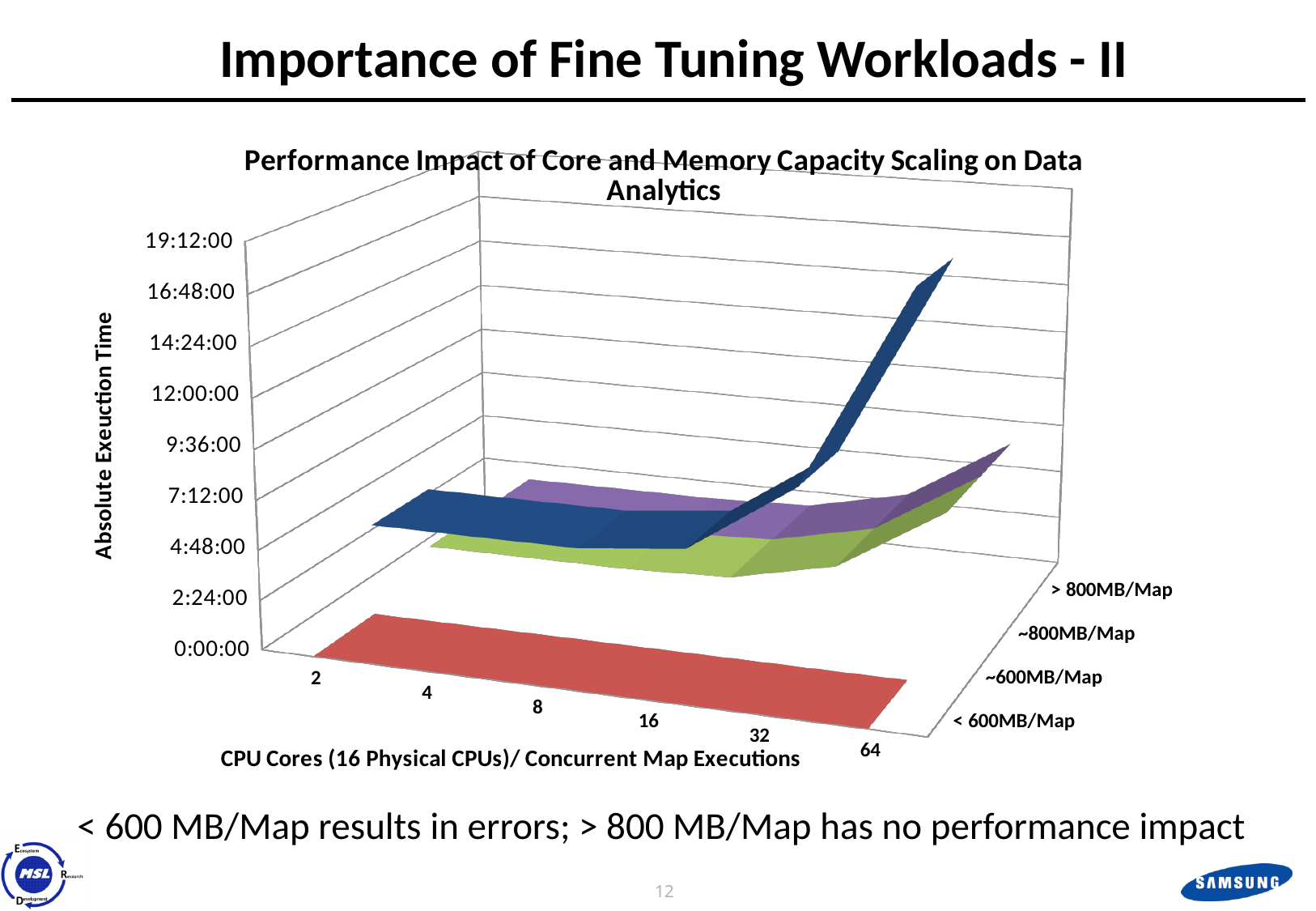
How many memory-per-map settings (series) are plotted in the chart? 4 Which memory-per-map setting has the lowest execution time across all CPU core values? < 600MB/Map Which memory-per-map setting has the highest execution time at 64 CPU cores? ~600MB/Map Which has the larger execution time at 64 CPU cores: > 800MB/Map or ~600MB/Map? ~600MB/Map Does the execution time for > 800MB/Map rise or fall as CPU cores increase from 32 to 64? rise What kind of chart is shown on the slide? 3D line chart What is the largest CPU core value shown on the x axis? 64 What is the label of the vertical axis of the chart? Absolute Exeuction Time What is the title of the chart? Performance Impact of Core and Memory Capacity Scaling on Data Analytics Is the execution time for < 600MB/Map at 64 CPU cores greater or less than 2:24:00? less Is the execution time for > 800MB/Map at 64 CPU cores greater or less than 9:36:00? less How many CPU core values are shown along the x axis of the chart? 6